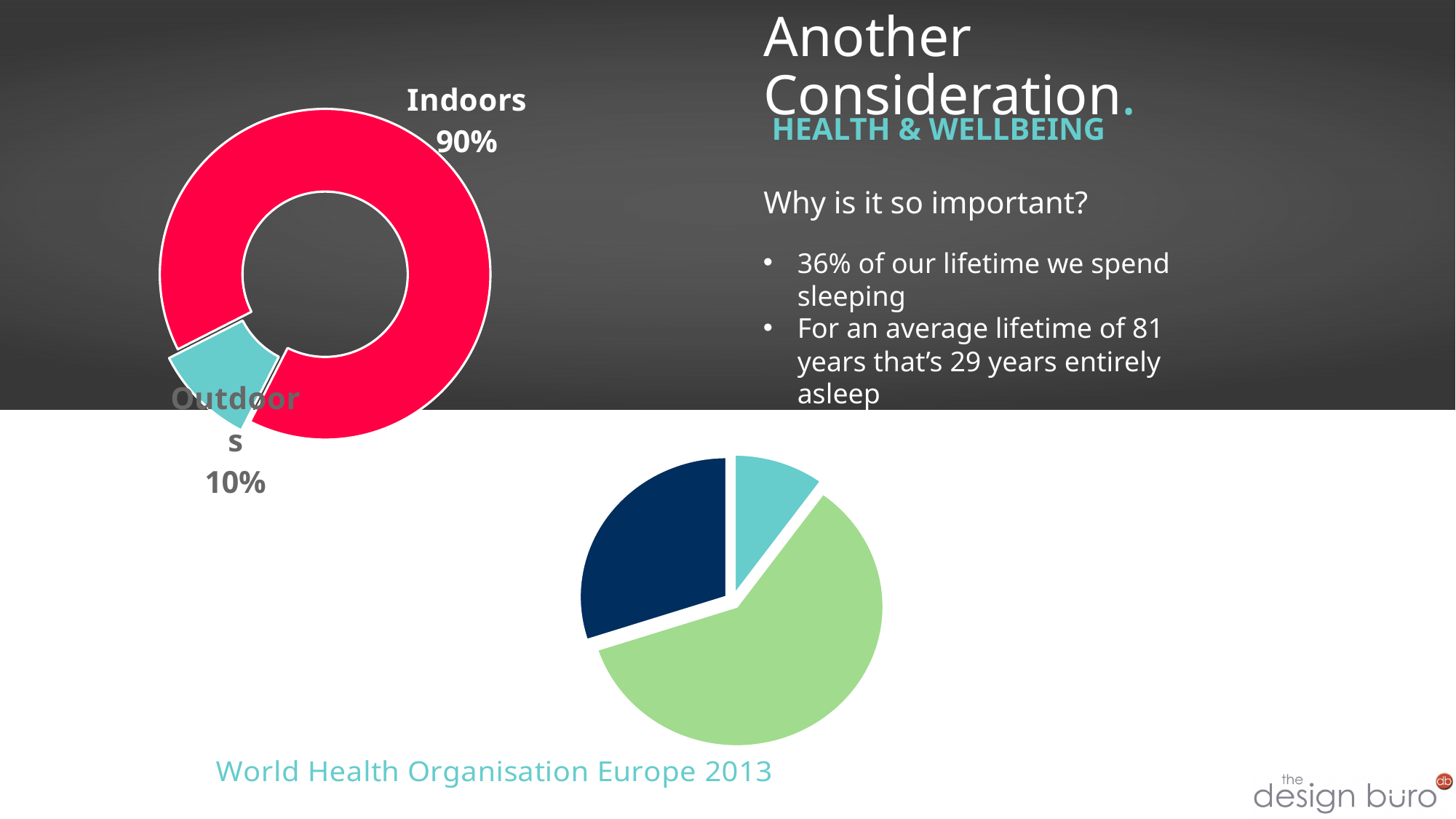
What kind of chart is the chart at the bottom centre of the slide? Pie chart In the doughnut chart at the top left, which is larger, Indoors or Outdoors? Indoors How many categories does the doughnut chart at the top left show? 2 How many slices does the pie chart at the bottom centre of the slide have? 3 What kind of chart is the chart at the top left of the slide? Doughnut chart In the doughnut chart at the top left, what is the value for Indoors? 90% In the doughnut chart at the top left, which category has the smallest share? Outdoors In the doughnut chart at the top left, what is the difference between the Indoors and Outdoors values? 80% In the doughnut chart at the top left, which category has the largest share? Indoors In the doughnut chart at the top left, what colour is the Indoors segment? Red In the doughnut chart at the top left, what is the value for Outdoors? 10% In the pie chart at the bottom centre of the slide, which colour slice is the largest? Light green